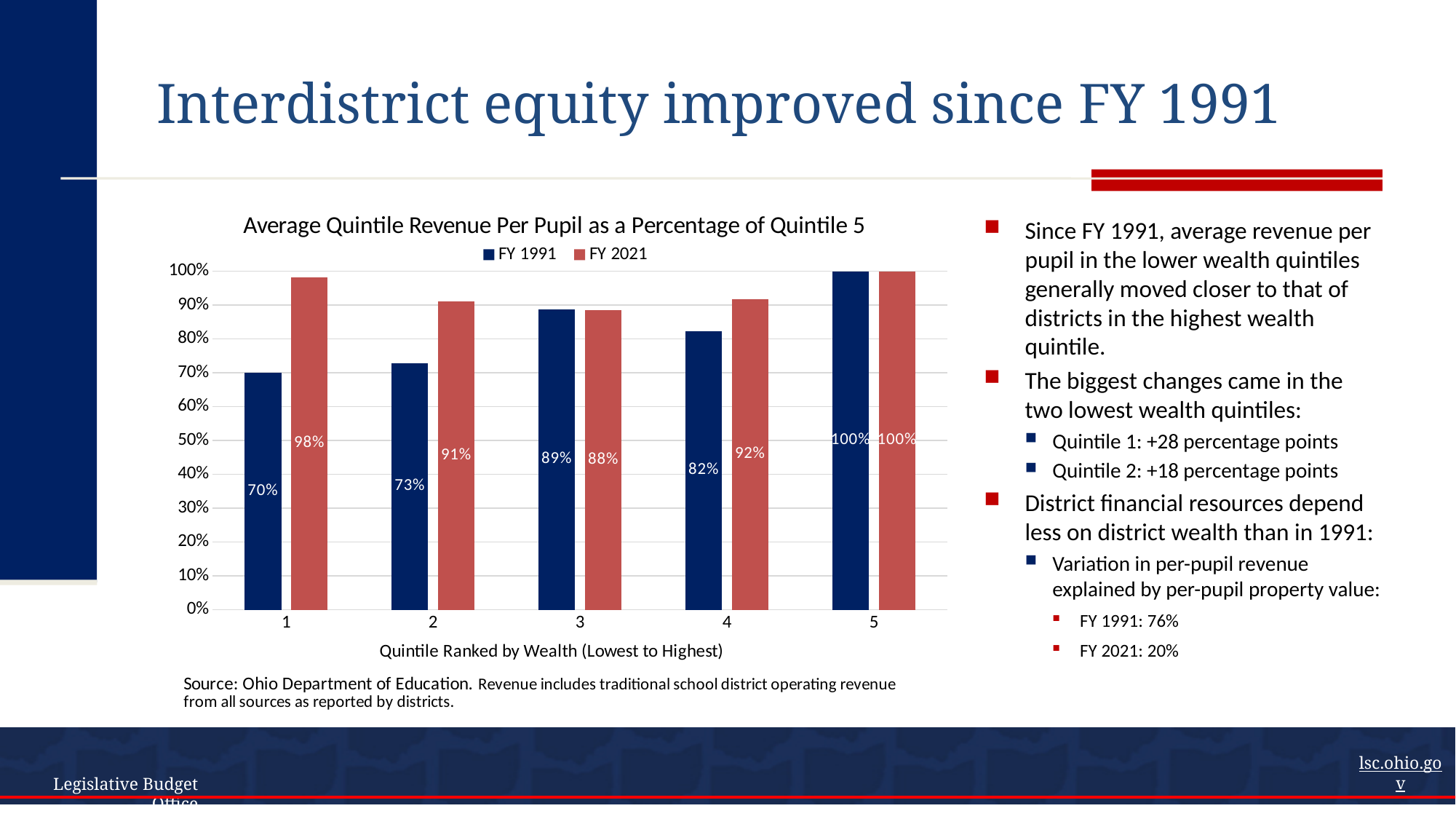
Which quintile has the lowest FY 1991 value? 1 Which quintile has the highest FY 2021 value? 5 What is the title of the chart? Average Quintile Revenue Per Pupil as a Percentage of Quintile 5 What is the FY 2021 value for quintile 4? 92% How many series does the legend list? 2 Is the FY 1991 value for quintile 4 greater or less than 90%? less What is the FY 1991 value for quintile 1? 70% Which is larger for quintile 3, the FY 1991 value or the FY 2021 value? FY 1991 How many quintiles are shown on the x axis? 5 What kind of chart is shown on the slide? bar chart What is the difference between the FY 2021 and FY 1991 values for quintile 1? 28 percentage points What is the FY 2021 value for quintile 2? 91%